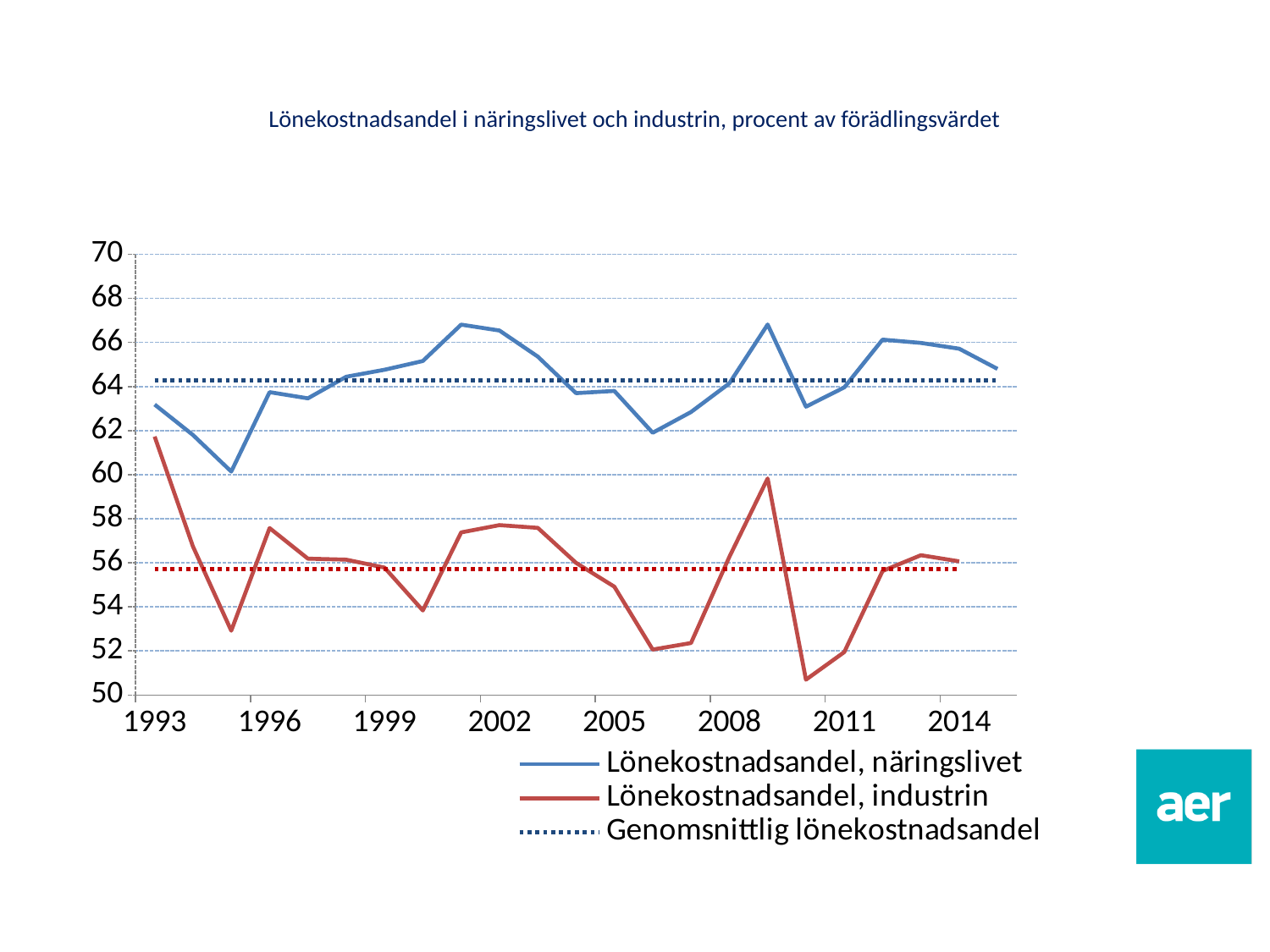
Is the value for Lönekostnadsandel, näringslivet in 2001 greater or less than 66? greater Which series has the higher value in 2009, Lönekostnadsandel, näringslivet or Lönekostnadsandel, industrin? Lönekostnadsandel, näringslivet How many series does the legend list? 3 What is the title of the chart? Lönekostnadsandel i näringslivet och industrin, procent av förädlingsvärdet Is the value for Lönekostnadsandel, näringslivet in 1995 greater or less than 62? less Is the value for Lönekostnadsandel, industrin in 1993 greater or less than 60? greater In which year is Lönekostnadsandel, näringslivet at its lowest? 1995 What kind of chart is shown on the slide? line chart In which year is Lönekostnadsandel, industrin at its lowest? 2010 What colour is the line for Lönekostnadsandel, industrin? red